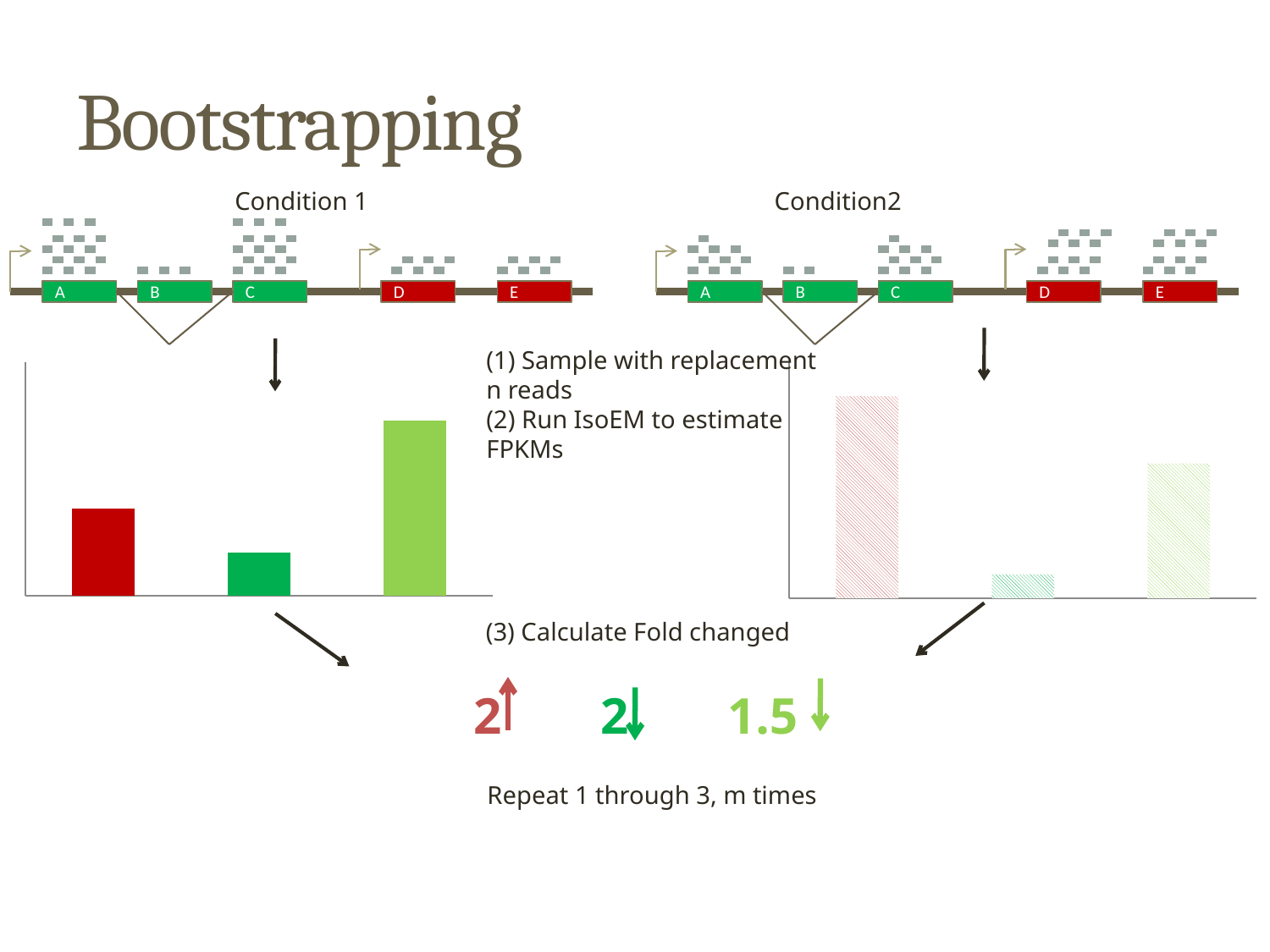
What kind of chart is shown on the left side of the slide under Condition 1? bar chart In the right chart (Condition 2), is the green bar taller or shorter than the light green bar? shorter What fold change value is shown in light green below the charts? 1.5 What is the title of the slide containing the two bar charts? Bootstrapping In the right chart (Condition 2), which is taller, the red bar or the light green bar? the red bar How many bars does the left chart (Condition 1) contain? 3 In the right chart (Condition 2), which bar is the shortest? the green (middle) bar In the left chart (Condition 1), which bar is the shortest? the green (middle) bar In the left chart (Condition 1), which bar is the tallest? the light green (third) bar In the right chart (Condition 2), which bar is the tallest? the red (first) bar In the left chart (Condition 1), which is taller, the red bar or the green bar? the red bar How many bars does the right chart (Condition 2) contain? 3